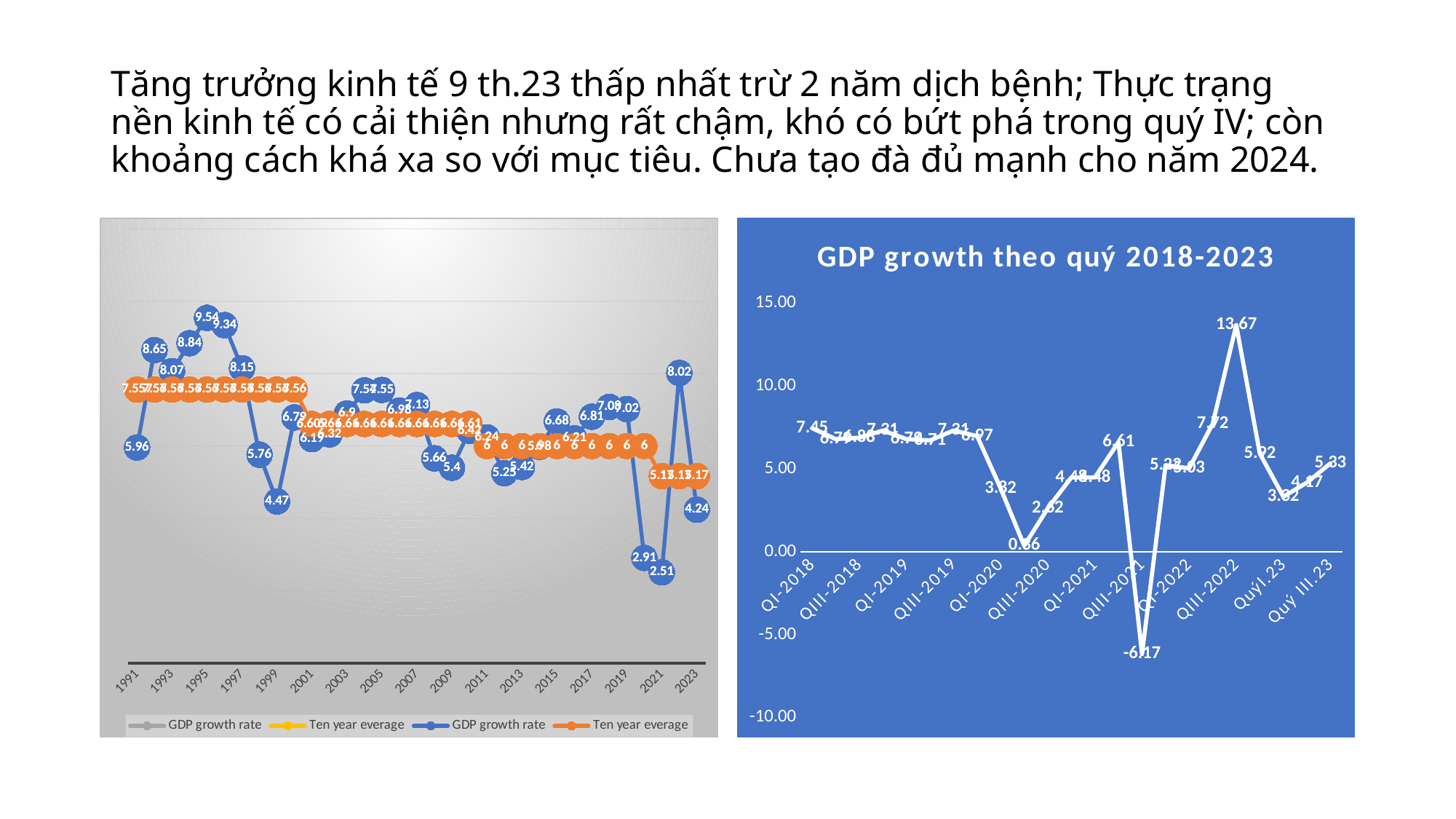
In the chart titled 'GDP growth theo quý 2018-2023', what is the value for Quý III.23? 5.33 In the left chart, what is the difference between the GDP growth rate in 2022 and in 2023? 3.78 In the left chart, which year has the highest GDP growth rate? 1995 In the chart titled 'GDP growth theo quý 2018-2023', what is the value for QI-2018? 7.45 In the left chart, what is the GDP growth rate for 2021? 2.51 In the chart titled 'GDP growth theo quý 2018-2023', which quarter has the highest value? QIII-2022 What kind of chart is the chart titled 'GDP growth theo quý 2018-2023'? line chart In the left chart, which year has the higher GDP growth rate, 1992 or 1993? 1992 In the left chart, what is the GDP growth rate for 2022? 8.02 In the chart titled 'GDP growth theo quý 2018-2023', what is the value for QIII-2021? -6.17 In the chart titled 'GDP growth theo quý 2018-2023', what is the highest value shown? 13.67 In the chart titled 'GDP growth theo quý 2018-2023', which quarter has the lowest value? QIII-2021